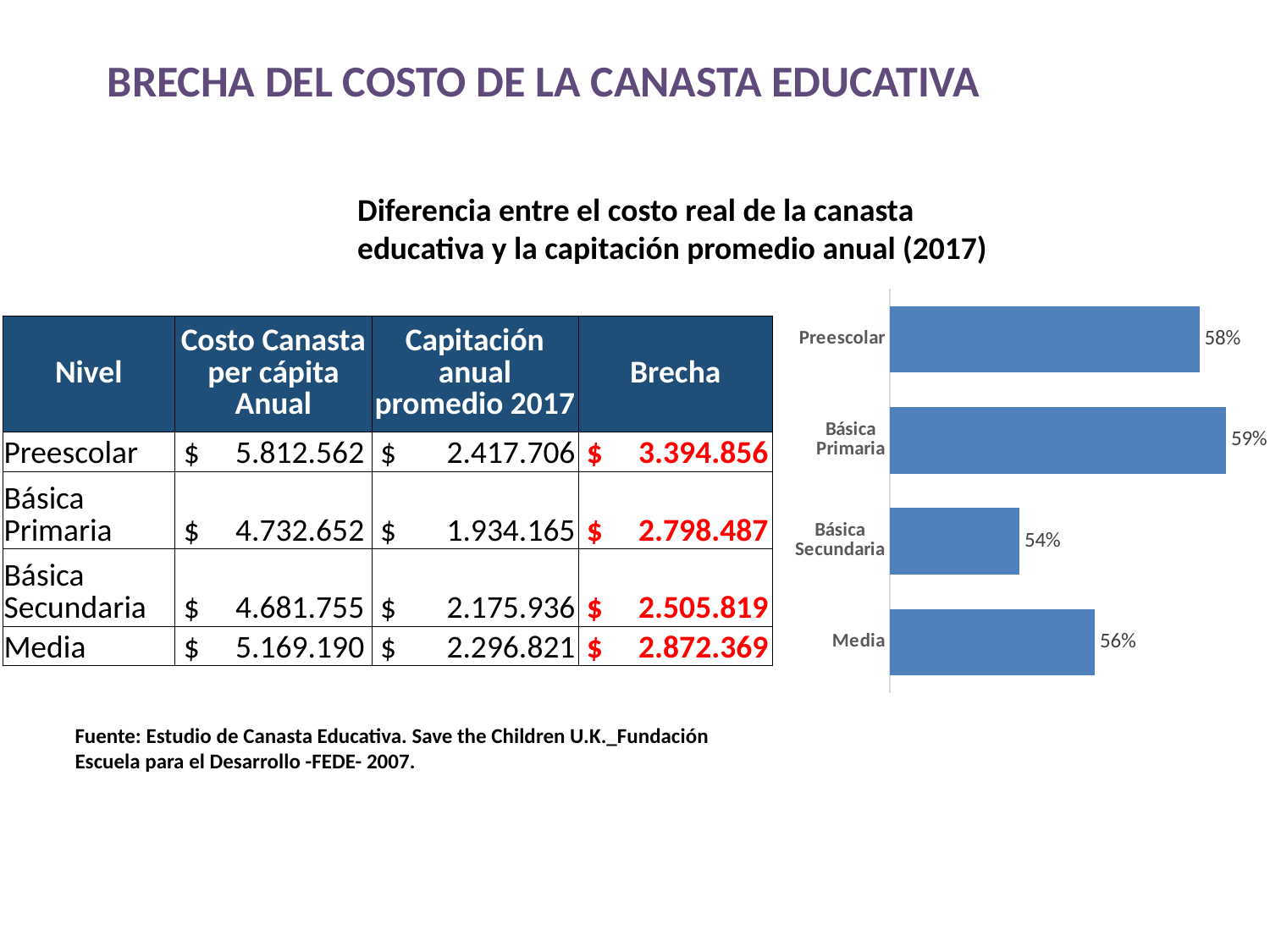
What is the value shown for Preescolar in the bar chart? 58% What is the value shown for Media in the bar chart? 56% What is the difference between the values for Preescolar and Media in the bar chart? 2% What is the value shown for Básica Secundaria in the bar chart? 54% Which category has the highest value in the bar chart? Básica Primaria How many categories are shown in the bar chart? 4 What colour are the bars in the chart? Blue What is the value shown for Básica Primaria in the bar chart? 59% In the bar chart, which is larger: the value for Media or the value for Básica Secundaria? Media What is the difference between the values for Básica Primaria and Básica Secundaria in the bar chart? 5% What kind of chart is shown on the slide? Bar chart Which category has the lowest value in the bar chart? Básica Secundaria